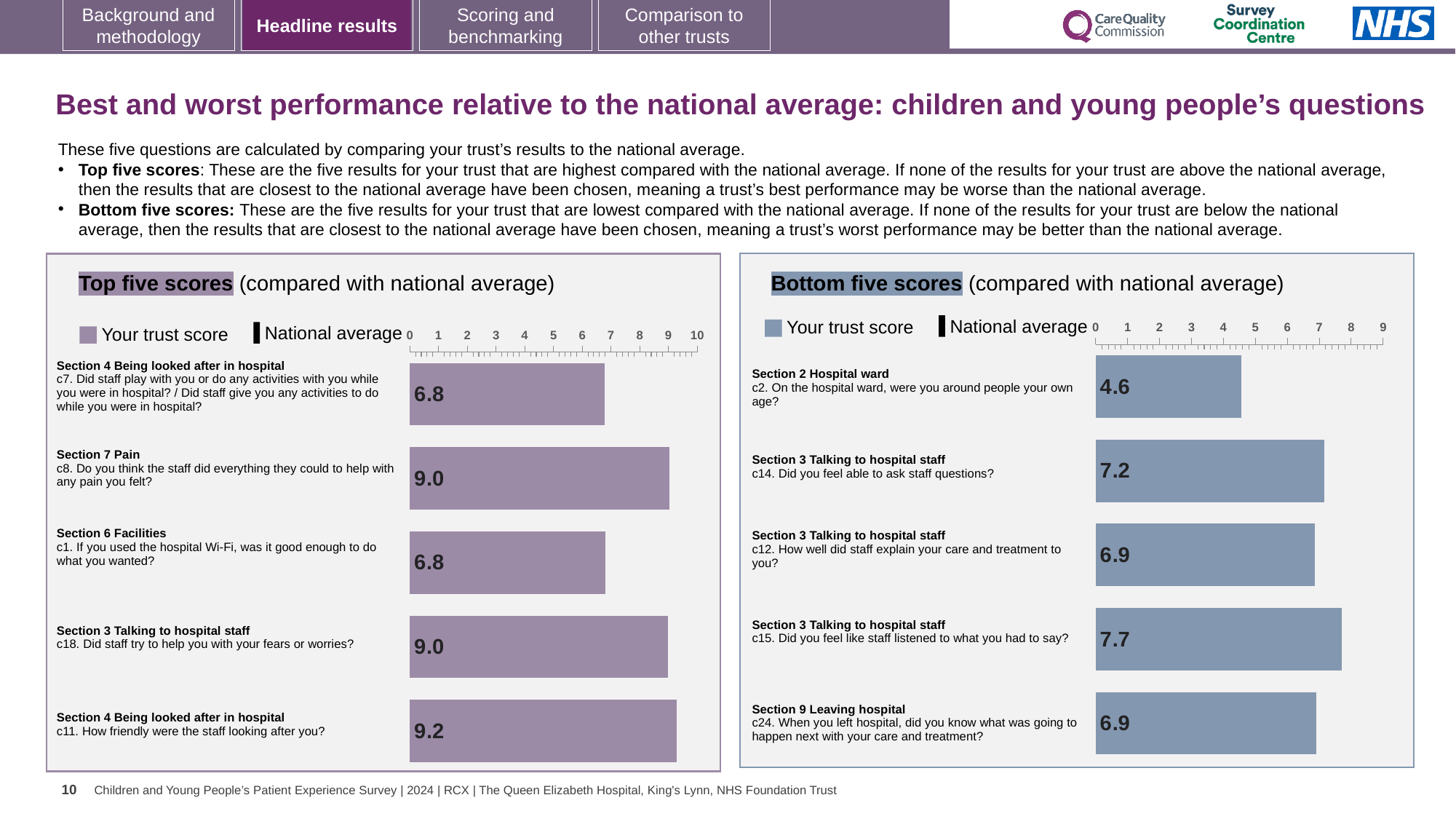
In the Bottom five scores chart, what is the difference between the trust scores for c15 and c2? 3.1 What two entries does the legend of the Top five scores chart list? Your trust score and National average In the Bottom five scores chart, what is the trust score for c15 (Did you feel like staff listened to what you had to say?)? 7.7 In the Top five scores chart, which question has the highest trust score? c11. How friendly were the staff looking after you? What type of chart is the Bottom five scores chart? Bar chart In the Top five scores chart, what is the trust score for c11 (How friendly were the staff looking after you?)? 9.2 In the Top five scores chart, what is the difference between the trust scores for c11 and c7? 0.4 In the Bottom five scores chart, what is the trust score for c2 (On the hospital ward, were you around people your own age?)? 4.6 In the Bottom five scores chart, which question has the lowest trust score? c2. On the hospital ward, were you around people your own age? In the Bottom five scores chart, which question has the highest trust score? c15. Did you feel like staff listened to what you had to say? How many bars are shown in the Top five scores chart? 5 In the Top five scores chart, which has the larger trust score: c8 (pain) or c1 (Wi-Fi)? c8